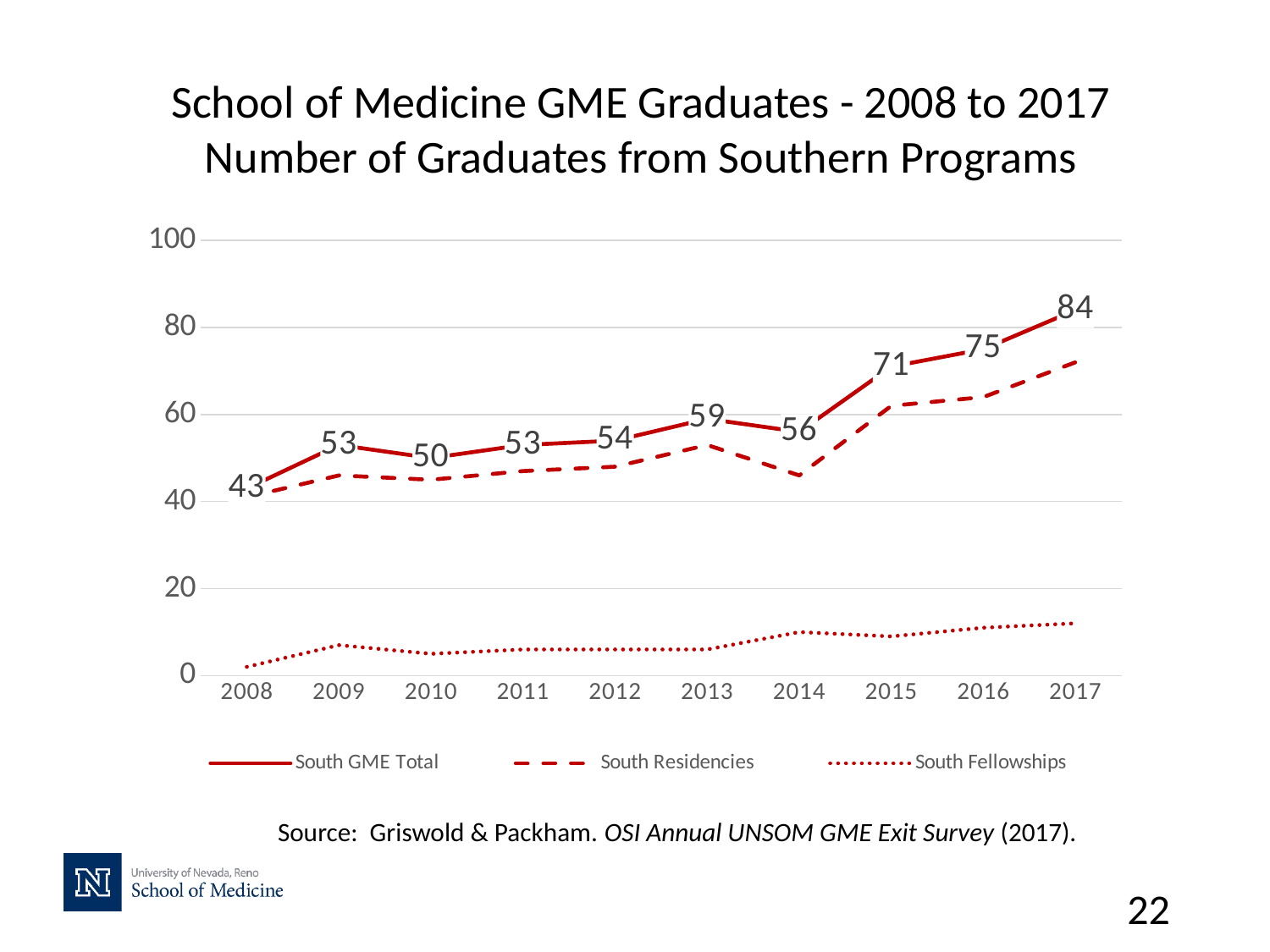
What is the difference between the South GME Total in 2017 and in 2008? 41 Is the South Fellowships value for 2012 greater or less than 20? less How many series does the legend list? 3 What is the South GME Total value for 2013? 59 What is the South GME Total value for 2017? 84 Is the South Residencies value for 2017 greater or less than 60? greater Which is larger, the South GME Total in 2013 or in 2014? 2013 Which year has the lowest South GME Total? 2008 What kind of chart is shown on the slide? line chart What is the South GME Total value for 2008? 43 Which year has the highest South GME Total? 2017 How many years are shown on the x axis? 10